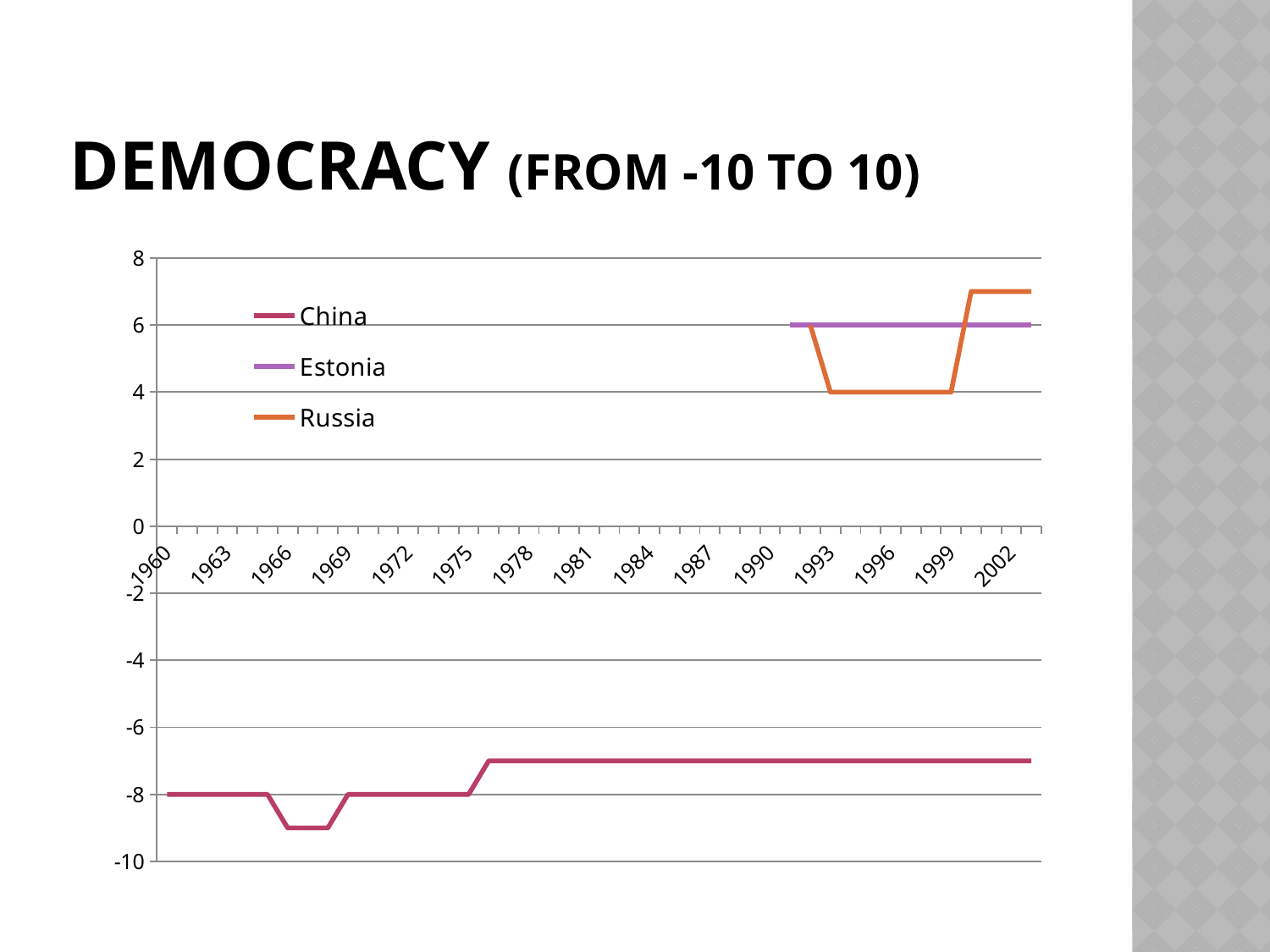
What is the democracy value for Russia in 1996? 4 Which series has the lowest values on the chart? China What is the democracy value for Estonia in 1996? 6 Is the value for Russia in 2002 greater or less than 6? greater Does the value for China rise or fall between 1960 and 2002 overall? rise What is the difference between Estonia's value and Russia's value in 1996? 2 Which series are listed in the legend? China, Estonia, Russia What kind of chart is shown on the slide? line chart In 1996, which is larger, the value for Estonia or the value for Russia? Estonia How many series does the legend list? 3 What is the democracy value for China in 1960? -8 Is the value for China in 2002 greater or less than -6? less